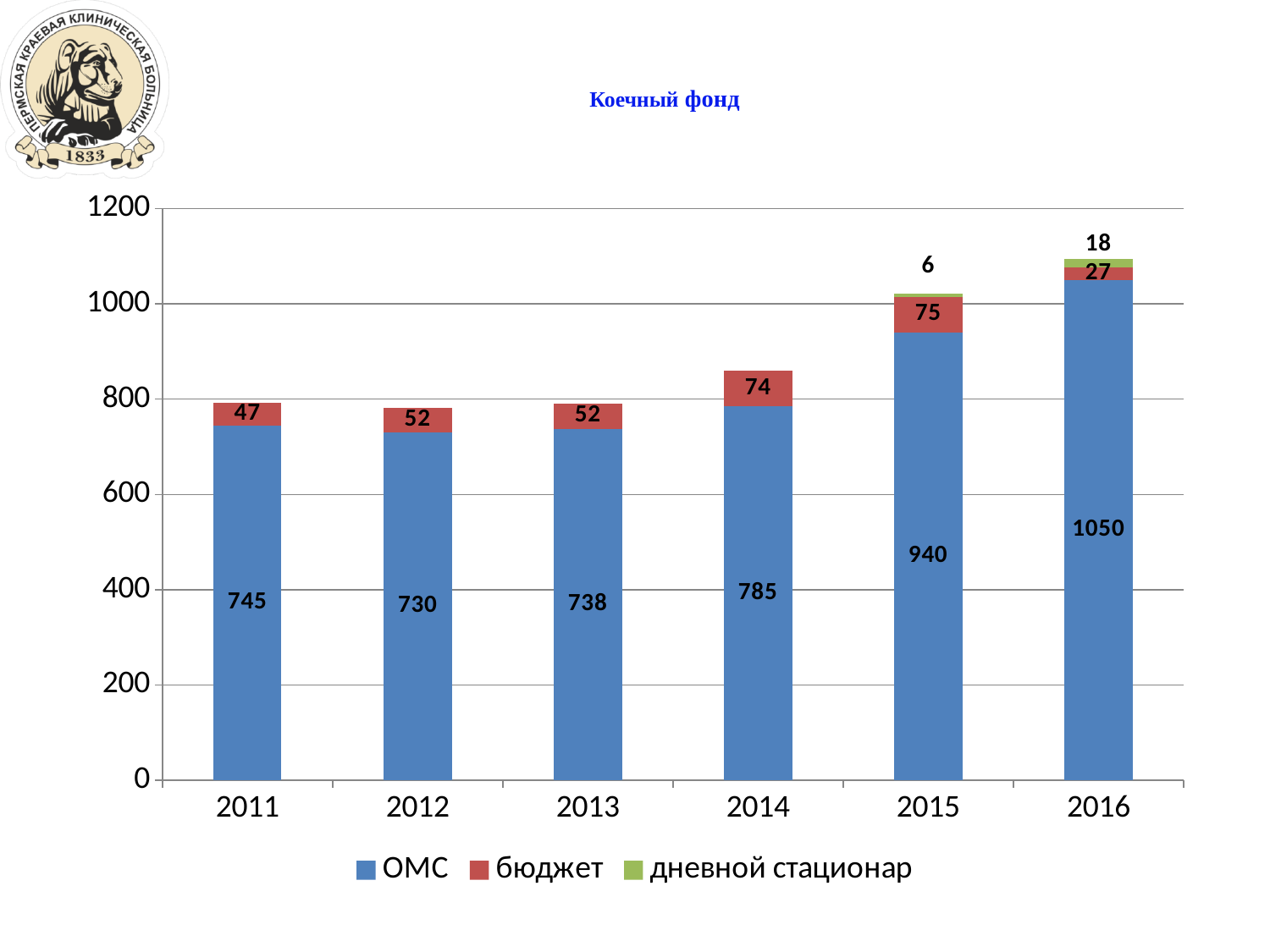
Which is larger, the бюджет value for 2014 or for 2016? 2014 What is the difference between the ОМС values for 2016 and 2015? 110 Which year has the highest ОМС value? 2016 Is the total of the stacked bar for 2015 greater or less than 1000? greater How many years are shown on the x axis? 6 Which year has the lowest ОМС value? 2012 What is the бюджет value for 2015? 75 What kind of chart is shown on the slide? stacked bar chart What is the total of the stacked bar for 2016? 1095 What is the дневной стационар value for 2016? 18 What is the ОМС value for 2014? 785 How many series does the legend list? 3